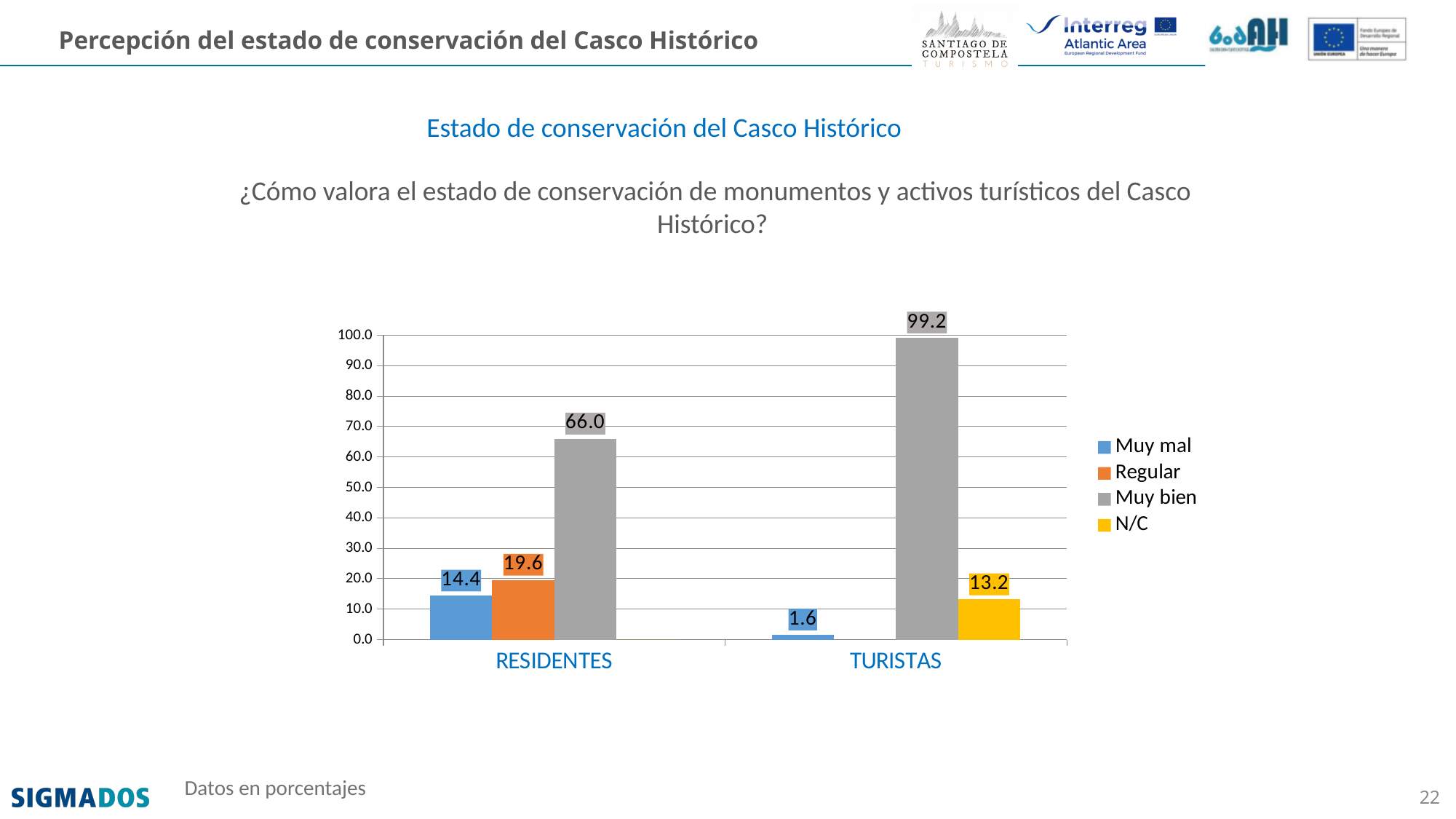
How many categories are shown on the x axis? 2 How many series does the legend list? 4 What is the difference between the Muy bien values for TURISTAS and RESIDENTES? 33.2 What is the value for Regular among RESIDENTES? 19.6 What kind of chart is shown on the slide? Bar chart What is the value for N/C among TURISTAS? 13.2 What is the value for Muy mal among TURISTAS? 1.6 What is the value for Muy bien among RESIDENTES? 66.0 Which series has the lowest labelled value among TURISTAS? Muy mal Which series has the highest value among RESIDENTES? Muy bien Which is larger among RESIDENTES: Muy mal or Regular? Regular What is the value for Muy bien among TURISTAS? 99.2